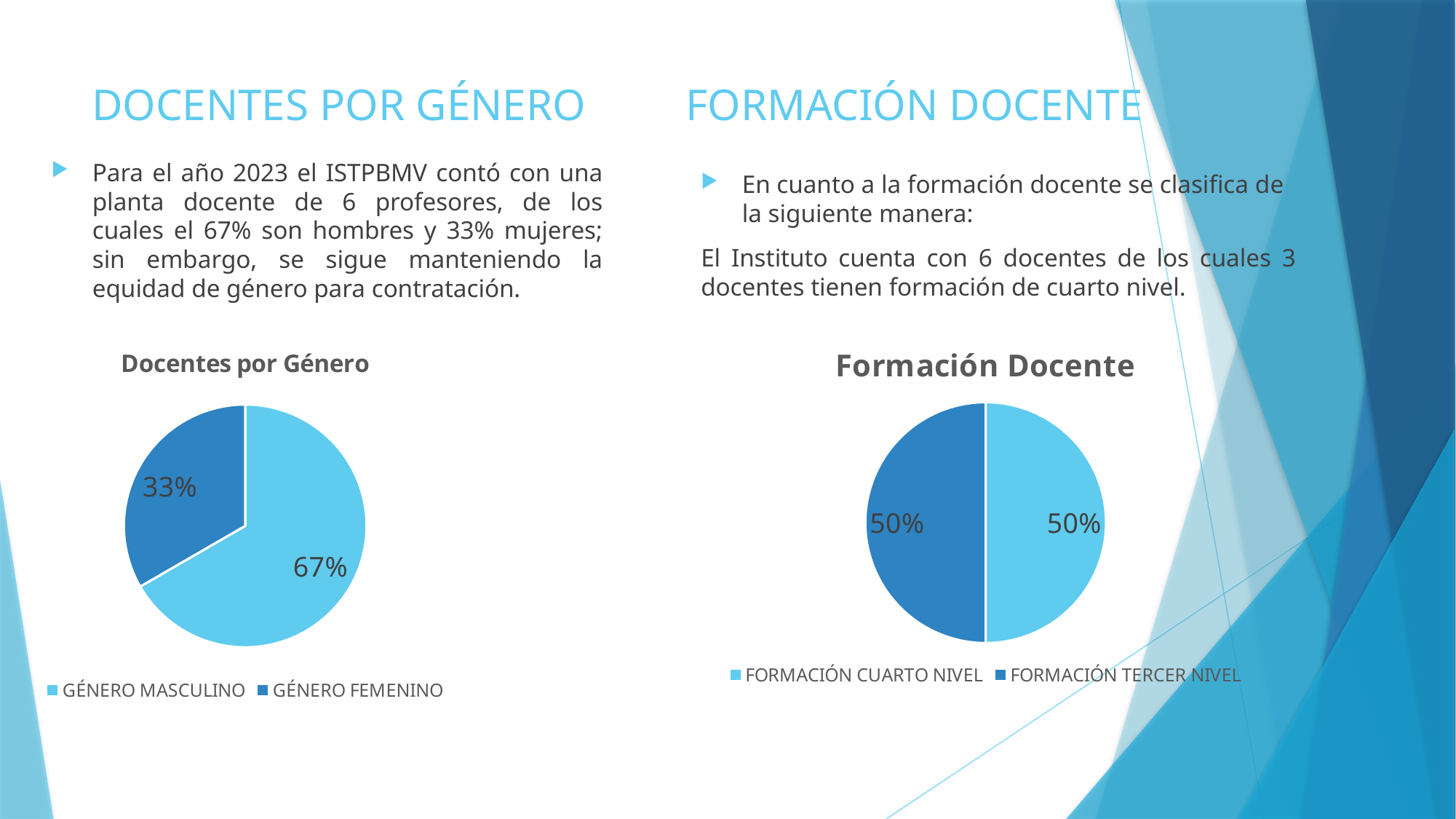
What kind of chart is 'Formación Docente'? Pie chart How many categories does the legend of the 'Docentes por Género' chart list? 2 In the 'Docentes por Género' chart, what share does GÉNERO FEMENINO have? 33% In the 'Formación Docente' chart, what share does FORMACIÓN CUARTO NIVEL have? 50% In the 'Docentes por Género' chart, which category has the largest slice? GÉNERO MASCULINO In the 'Formación Docente' chart, what share does FORMACIÓN TERCER NIVEL have? 50% How many categories does the legend of the 'Formación Docente' chart list? 2 In the 'Docentes por Género' chart, what is the difference in percentage points between GÉNERO MASCULINO and GÉNERO FEMENINO? 34 In the 'Docentes por Género' chart, which is larger, GÉNERO MASCULINO or GÉNERO FEMENINO? GÉNERO MASCULINO In the 'Docentes por Género' chart, which category has the smallest slice? GÉNERO FEMENINO What kind of chart is 'Docentes por Género'? Pie chart